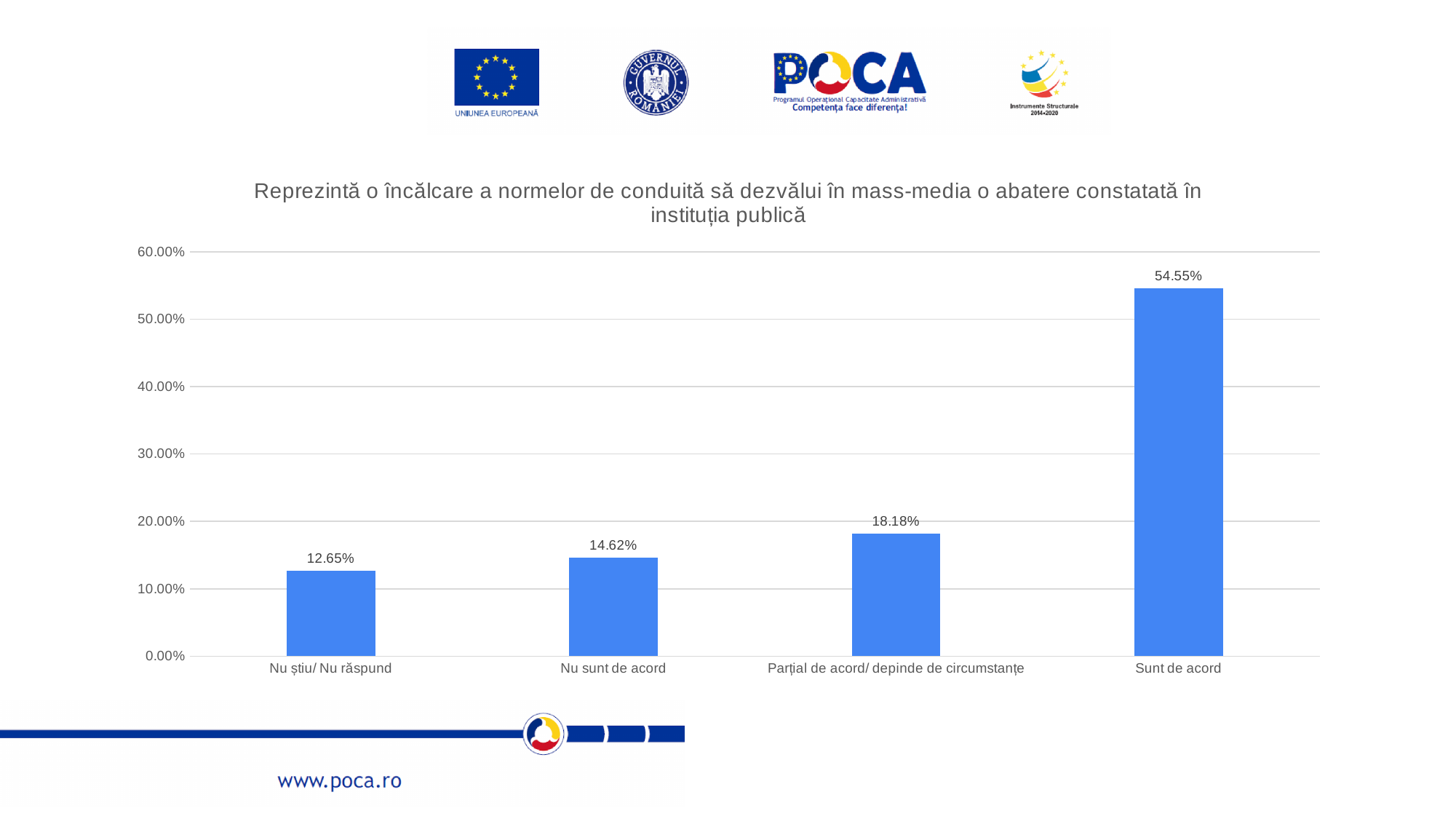
What is the value for "Nu știu/ Nu răspund"? 12.65% What is the difference between the values for "Sunt de acord" and "Parțial de acord/ depinde de circumstanțe"? 36.37% What is the value for "Sunt de acord"? 54.55% What is the value for "Parțial de acord/ depinde de circumstanțe"? 18.18% Is the value for "Sunt de acord" greater or less than 50.00%? greater Which is larger, the value for "Nu sunt de acord" or the value for "Parțial de acord/ depinde de circumstanțe"? Parțial de acord/ depinde de circumstanțe Which category has the highest value? Sunt de acord Which category has the lowest value? Nu știu/ Nu răspund What is the value for "Nu sunt de acord"? 14.62% How many categories are shown on the x axis? 4 What kind of chart is shown on the slide? bar chart Do the values rise or fall from left to right along the x axis? rise